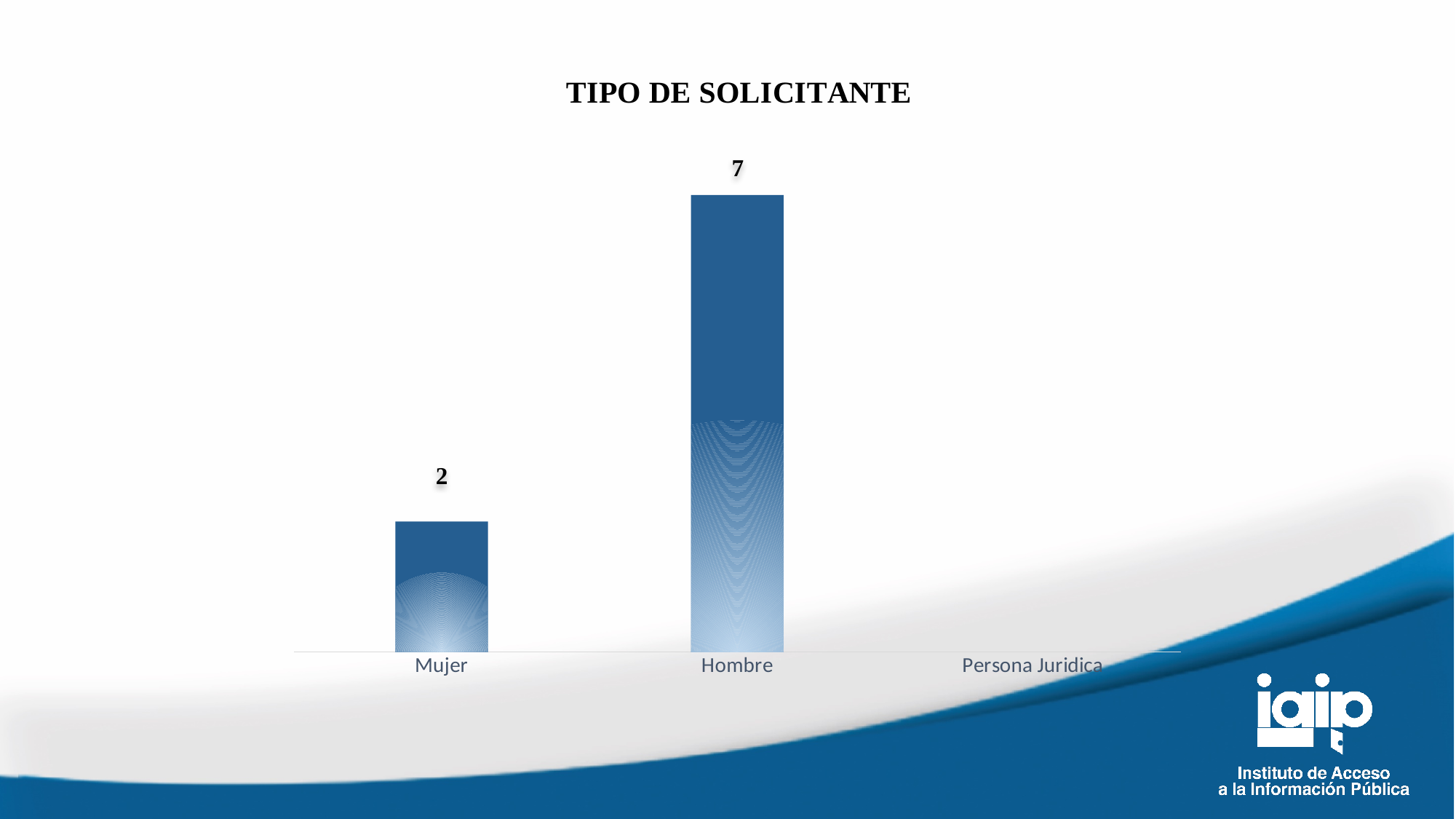
Which category has the highest value? Hombre Which category has no visible bar? Persona Juridica What is the value for Mujer? 2 What is the total of the values for Mujer and Hombre? 9 What is the value for Hombre? 7 What kind of chart is this? Bar chart Which is larger, the value for Mujer or the value for Hombre? Hombre What is the difference between the values for Hombre and Mujer? 5 What is the title of the chart? TIPO DE SOLICITANTE How many categories are shown on the x axis? 3